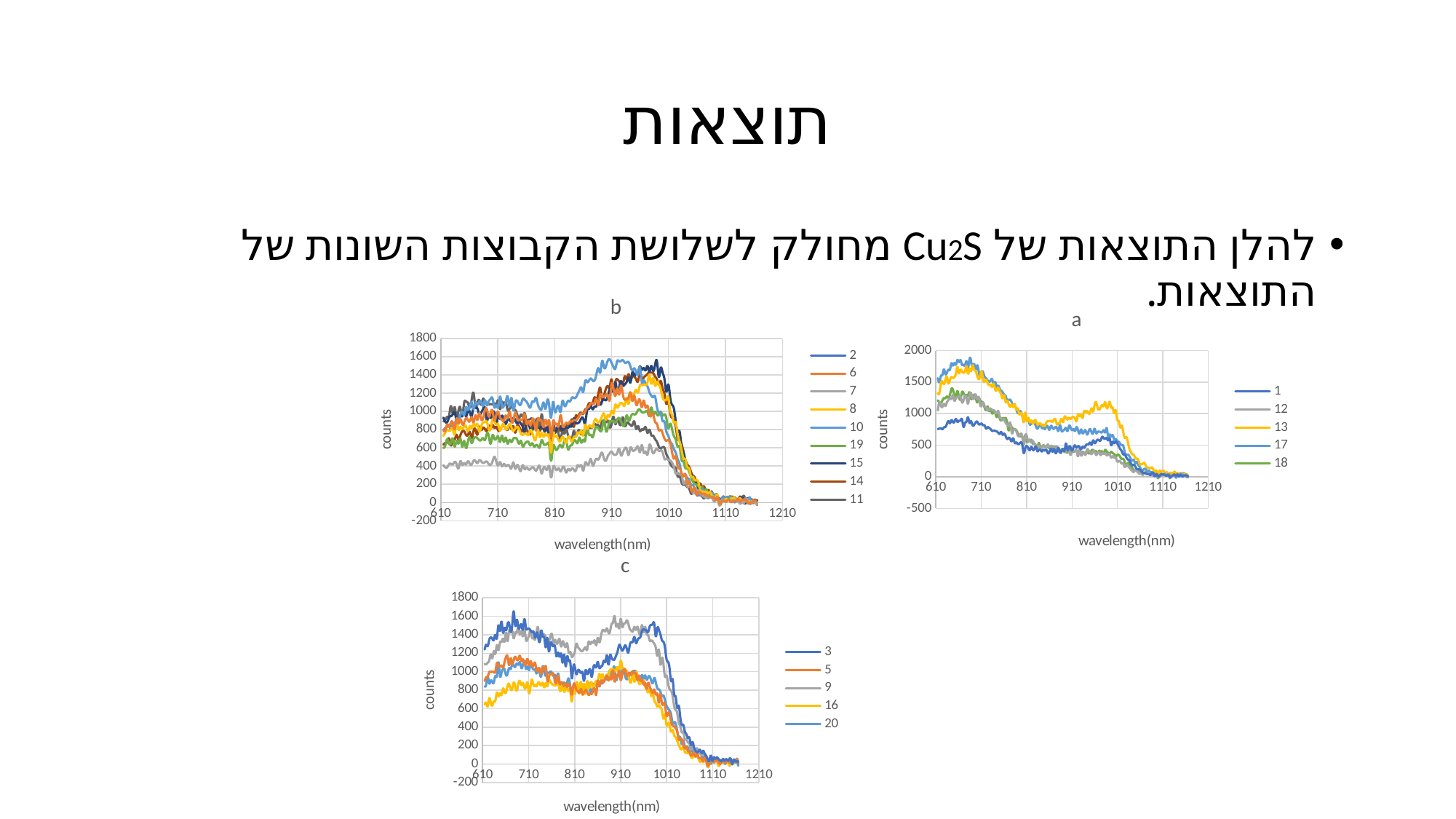
What kind of chart is chart b? line chart In chart b, is the value of series 7 at 710 nm greater or less than 800? less In chart c, is the value of series 16 at 610 nm greater or less than 1000? less What is the x-axis title of chart c? wavelength(nm) What is the y-axis title of chart a? counts How many series does the legend of chart b list? 9 How many series does the legend of chart c list? 5 How many series does the legend of chart a list? 5 In chart a, is the value of series 17 at 660 nm greater or less than 1500? greater In chart b, which series has the lowest counts across most of the wavelength range? 7 In chart c, do the counts rise or fall between 1010 nm and 1110 nm? fall